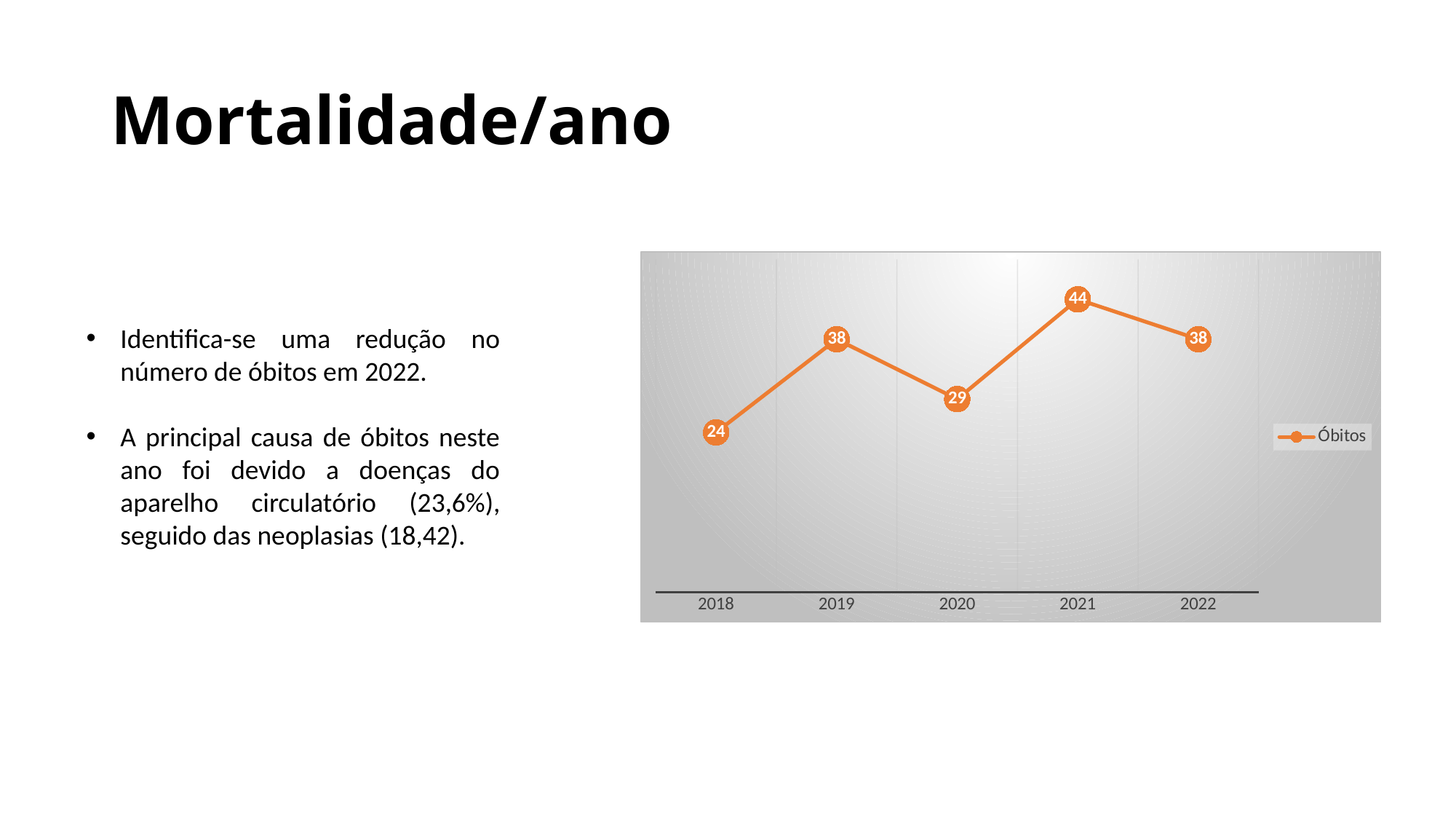
What is the name of the series shown in the chart legend? Óbitos Which year has the highest number of Óbitos? 2021 What is the difference between the Óbitos values for 2021 and 2022? 6 Which year has a larger Óbitos value, 2020 or 2021? 2021 How many series does the chart legend list? 1 What is the value for Óbitos in 2020? 29 Which year has the lowest number of Óbitos? 2018 What is the value for Óbitos in 2018? 24 What is the difference between the Óbitos values for 2019 and 2018? 14 What kind of chart is shown on the slide? line chart What is the value for Óbitos in 2022? 38 How many years are plotted on the x axis of the chart? 5